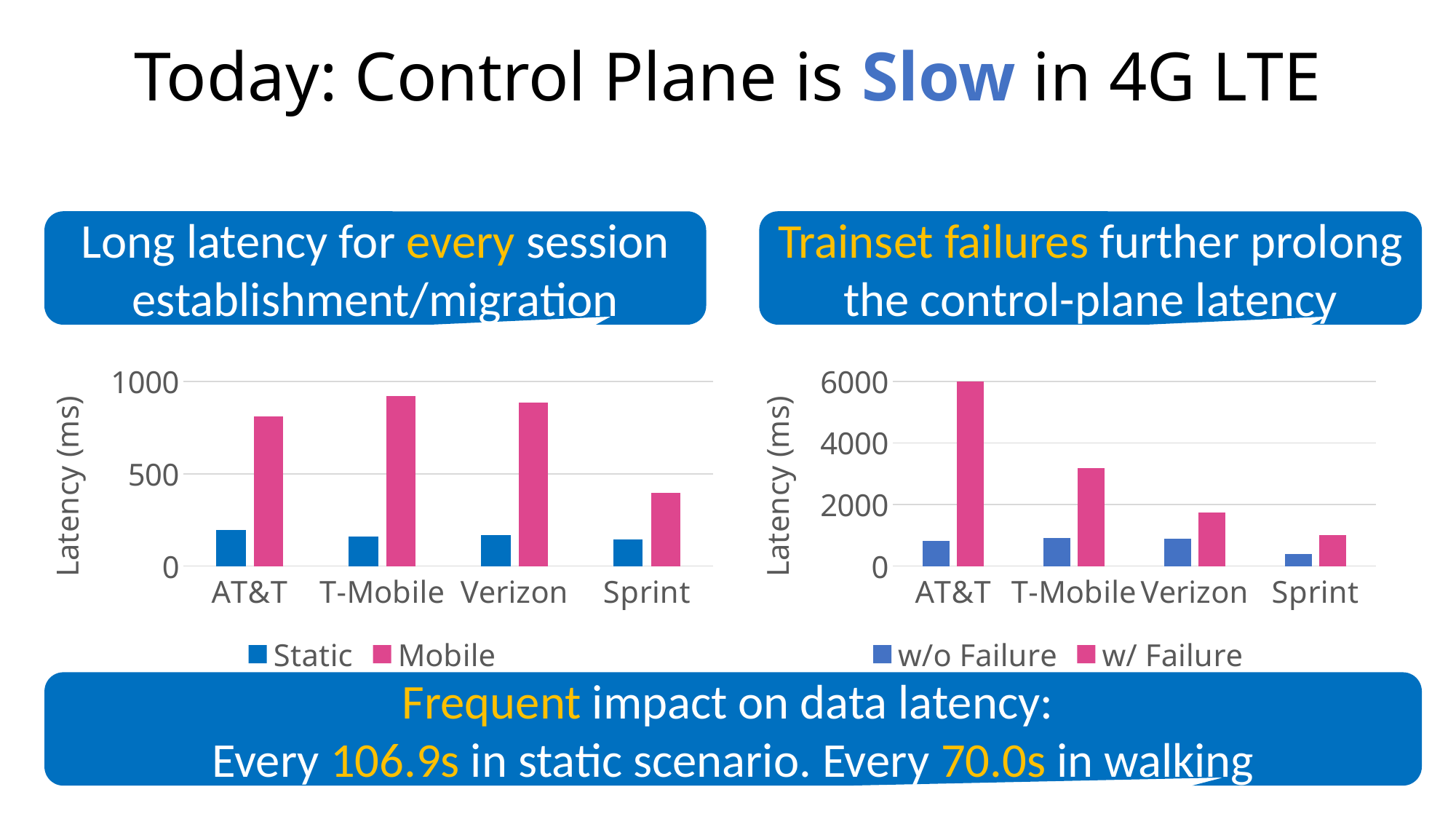
What are the two legend entries of the right chart? w/o Failure, w/ Failure In the right chart, is the w/ Failure value for AT&T greater or less than 4000? greater In the left chart, which carrier has the lowest Mobile latency? Sprint In the left chart, is the Mobile value for AT&T greater or less than 500? greater How many carriers are shown on the x axis of the left chart? 4 In the right chart, which carrier has the lowest w/o Failure latency? Sprint In the right chart, is the w/ Failure value for Verizon greater or less than 2000? less What kind of chart is the left chart on the slide? bar chart How many series does the legend of the left chart list? 2 In the right chart, which carrier has the highest w/ Failure latency? AT&T In the left chart, which is larger for T-Mobile, the Static or the Mobile value? Mobile